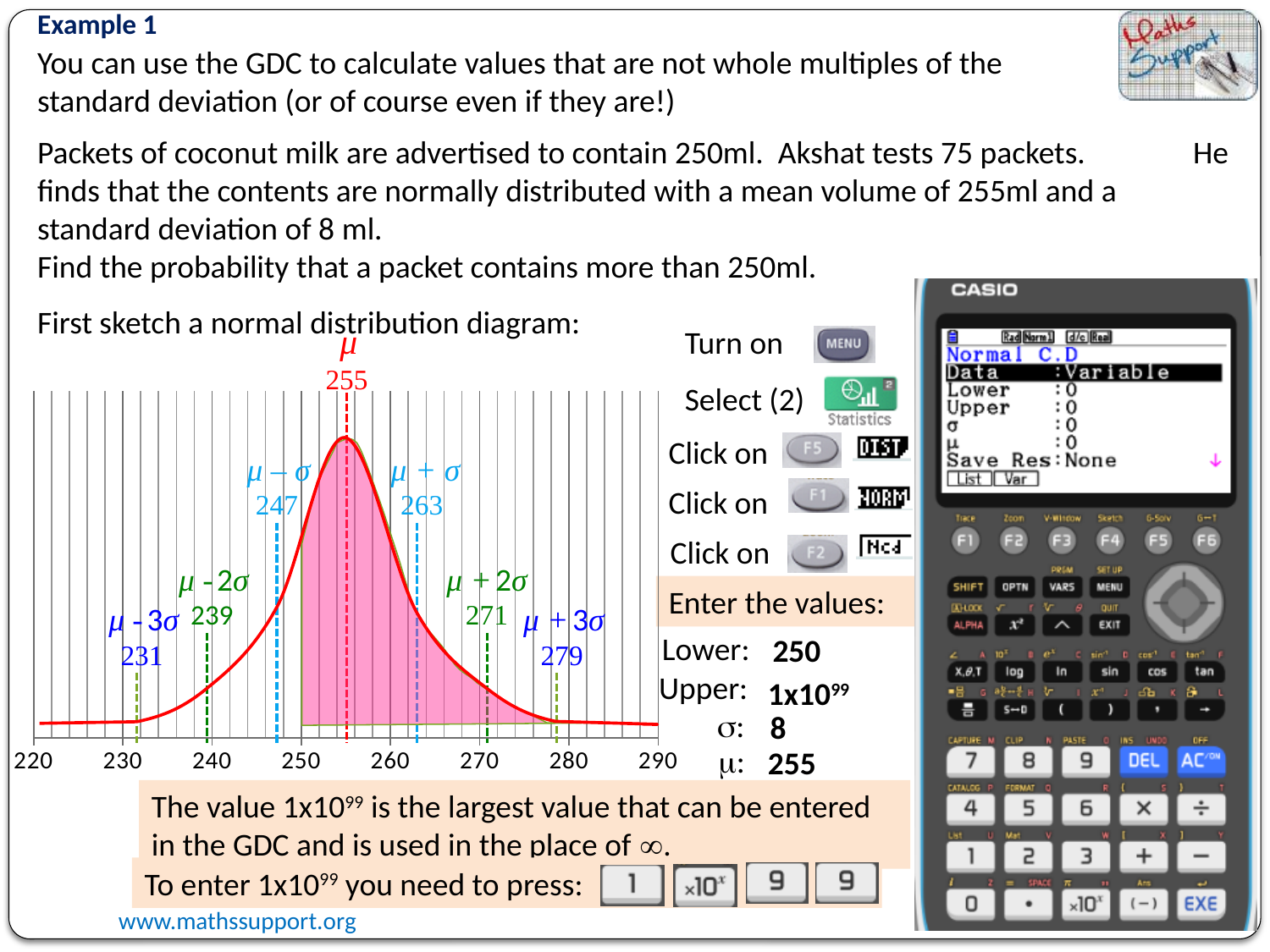
What value is labelled at μ − σ on the normal distribution diagram? 247 What value is labelled at the mean μ on the normal distribution diagram? 255 Does the curve on the normal distribution diagram rise or fall as x increases from 260 to 280? fall What is the difference between the values labelled at μ + 3σ and μ on the normal distribution diagram? 24 What value is labelled at μ − 3σ on the normal distribution diagram? 231 What value is labelled at μ + 3σ on the normal distribution diagram? 279 What value is labelled at μ + 2σ on the normal distribution diagram? 271 What is the difference between the values labelled at μ + σ and μ − σ on the normal distribution diagram? 16 What kind of chart is the normal distribution diagram on the slide? line chart How many labelled tick values are shown on the x axis of the normal distribution diagram? 8 At which x value does the shaded region under the normal distribution curve begin? 250 What value is labelled at μ + σ on the normal distribution diagram? 263